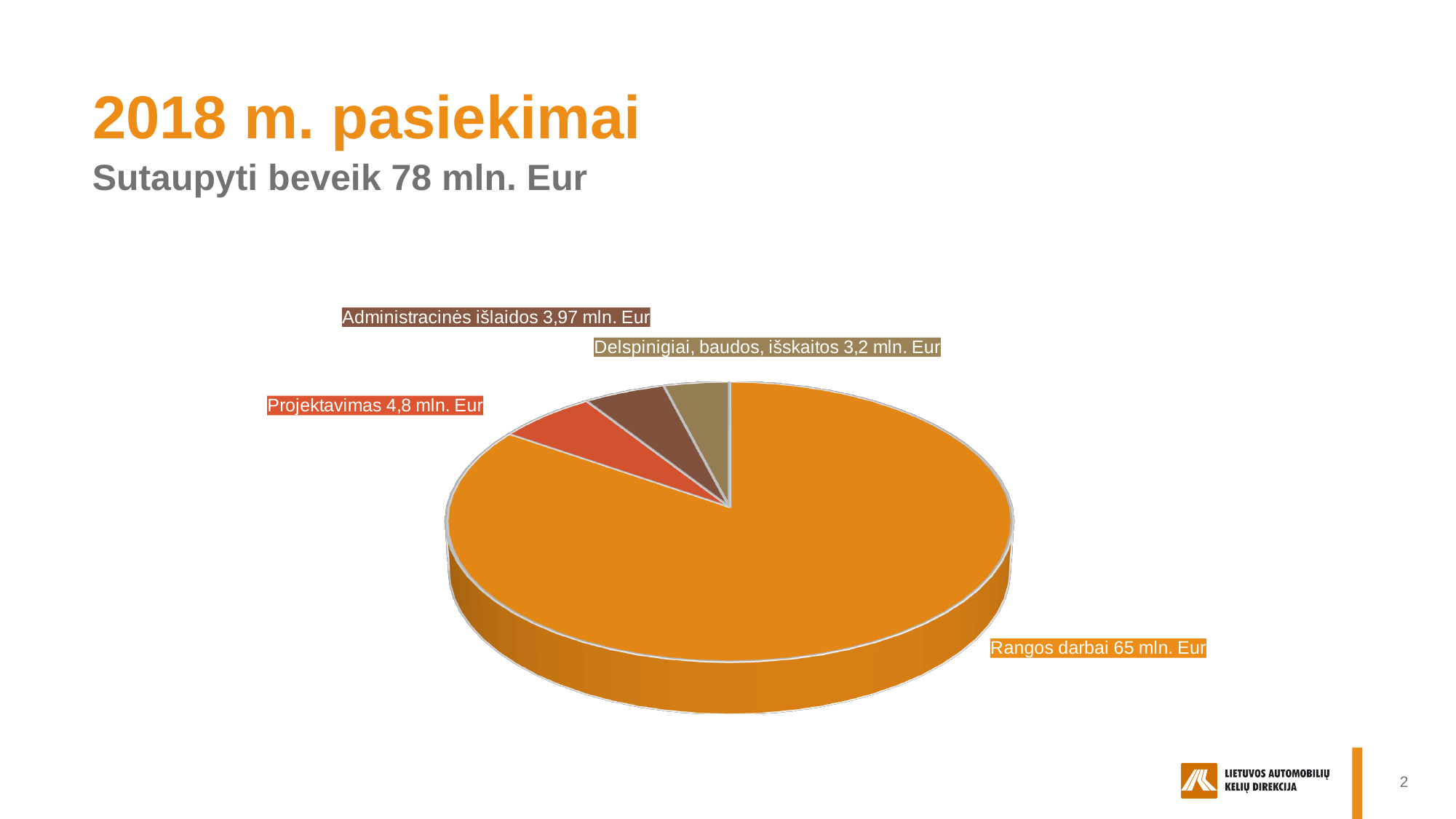
What is the difference between the values for Rangos darbai and Projektavimas? 60,2 mln. Eur What is the value for Projektavimas? 4,8 mln. Eur How many slices does the pie chart have? 4 What is the value for Delspinigiai, baudos, išskaitos? 3,2 mln. Eur Which is larger, the value for Administracinės išlaidos or the value for Delspinigiai, baudos, išskaitos? Administracinės išlaidos Which category has the largest slice of the pie? Rangos darbai What is the value for Administracinės išlaidos? 3,97 mln. Eur What is the difference between the values for Projektavimas and Delspinigiai, baudos, išskaitos? 1,6 mln. Eur What is the title of the slide containing the pie chart? 2018 m. pasiekimai What is the value for Rangos darbai? 65 mln. Eur Which category has the smallest slice of the pie? Delspinigiai, baudos, išskaitos What type of chart is shown on the slide? pie chart